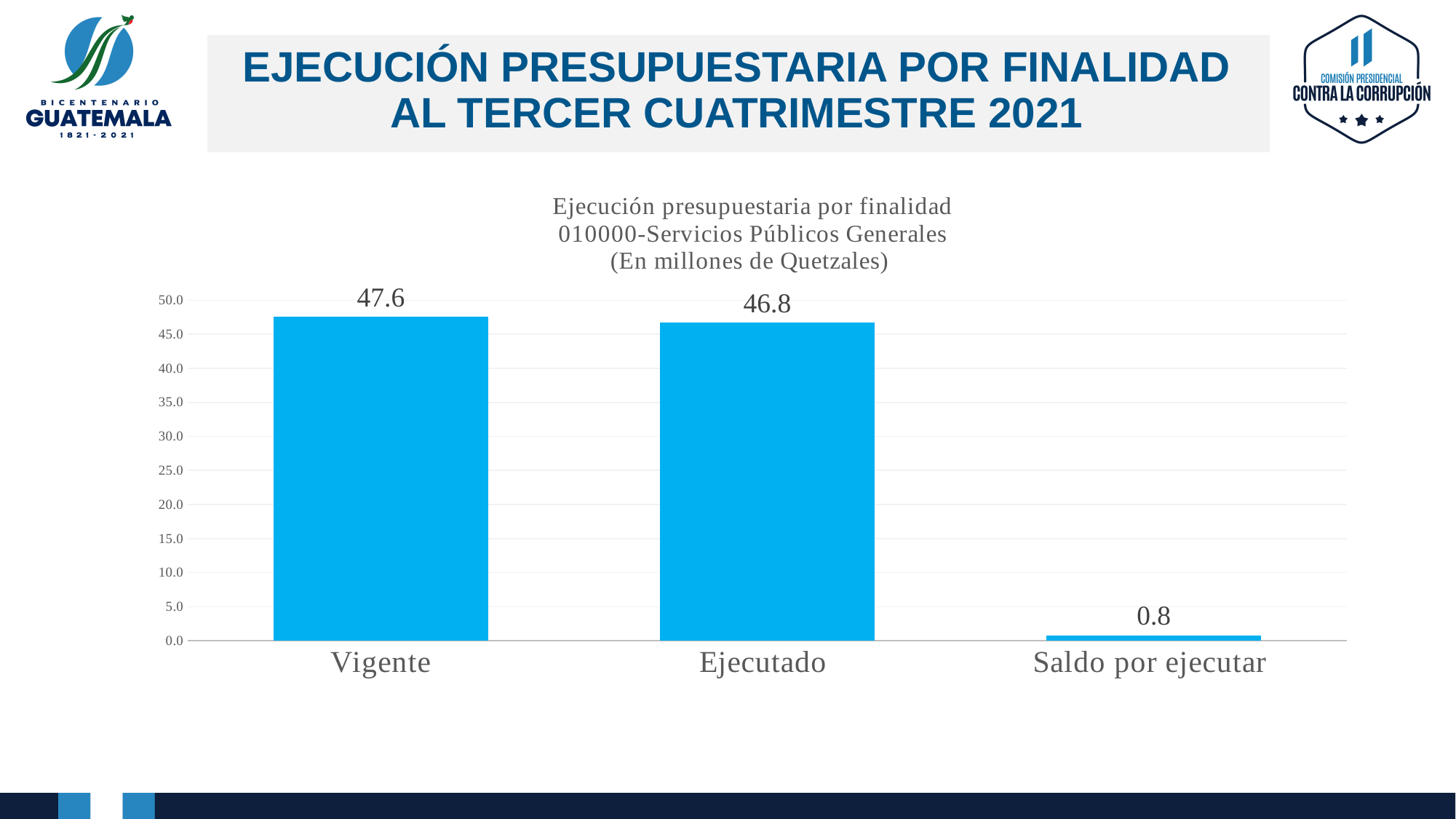
What is the value for Ejecutado? 46.8 What is the value for Vigente? 47.6 In what unit are the values in the chart expressed, according to the chart title? millones de Quetzales Which is larger, the value for Ejecutado or the value for Saldo por ejecutar? Ejecutado What is the difference between the values for Vigente and Ejecutado? 0.8 What is the difference between the values for Ejecutado and Saldo por ejecutar? 46.0 Which category has the highest value? Vigente How many categories are shown on the x axis? 3 What kind of chart is shown on the slide? bar chart Is the value for Ejecutado greater or less than 45.0? greater Which category has the lowest value? Saldo por ejecutar What is the value for Saldo por ejecutar? 0.8